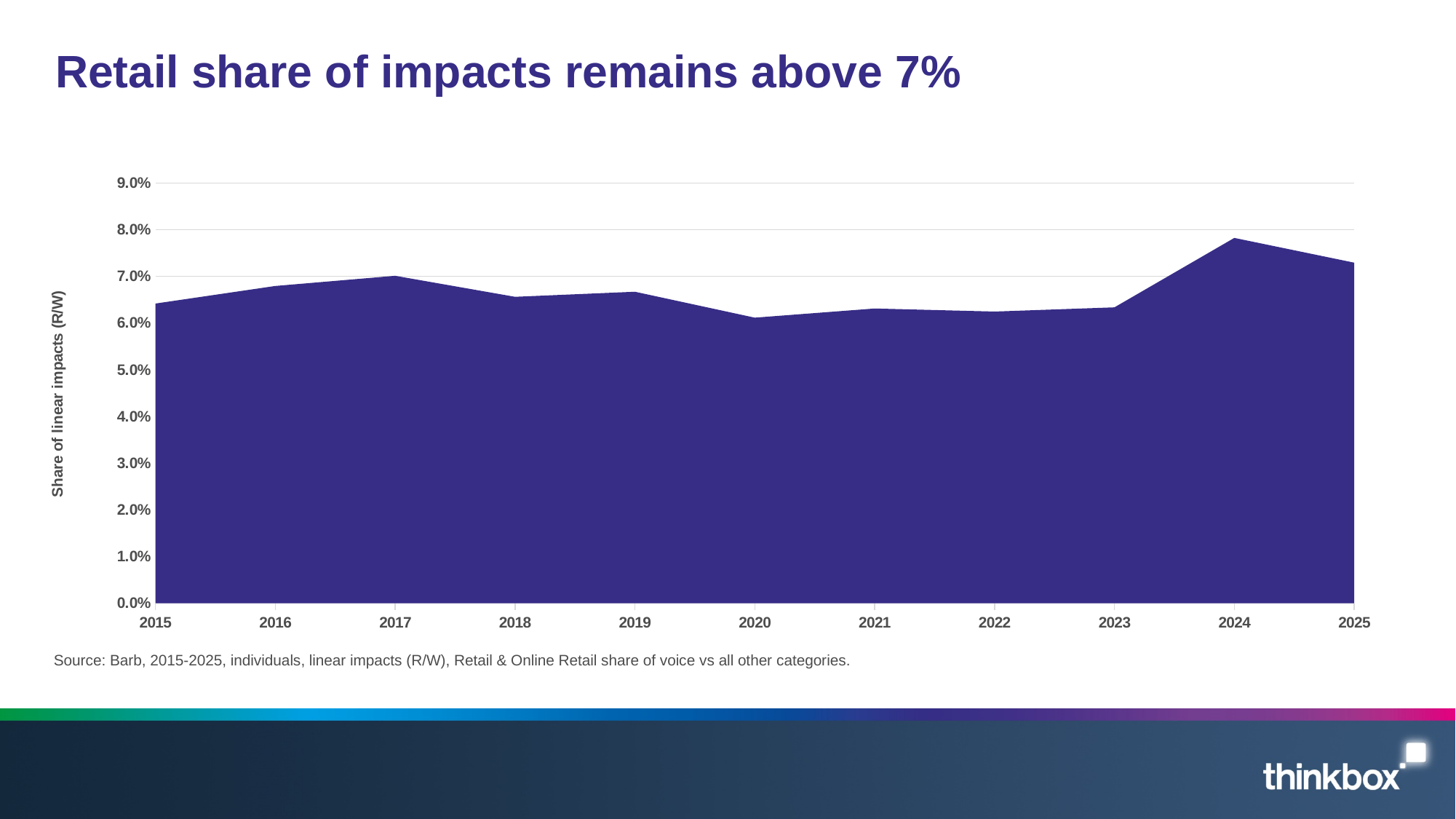
What is the label on the y axis of the chart? Share of linear impacts (R/W) Does the share of linear impacts rise or fall from 2023 to 2024? rise Is the value for 2025 greater or less than 7.0%? greater Which year has the larger share of linear impacts, 2017 or 2020? 2017 Is the value for 2020 greater or less than 7.0%? less Which year has the larger share of linear impacts, 2024 or 2015? 2024 Which year has the lowest share of linear impacts? 2020 Is the value for 2015 greater or less than 6.0%? greater What kind of chart is shown on the slide? Area chart Which year has the highest share of linear impacts? 2024 How many years are plotted along the x axis? 11